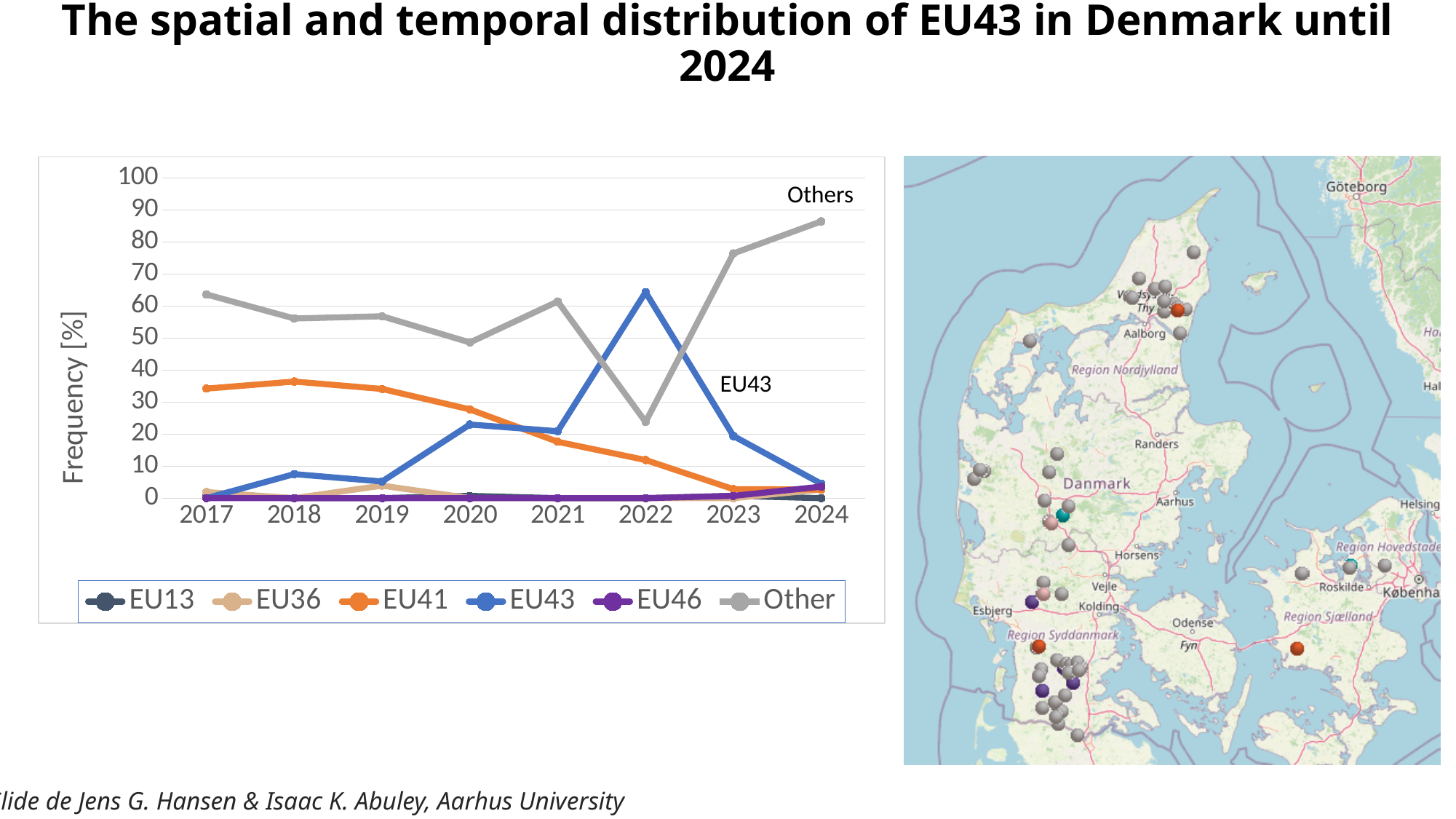
Is the value for EU41 in 2023 greater or less than 10? less In 2022, which series has the larger value, EU43 or Other? EU43 Is the value for EU43 in 2022 greater or less than 60? greater Does the EU41 series rise or fall from 2018 to 2024? fall What kind of chart is shown on the left of the slide? line chart Is the value for EU41 in 2018 greater or less than 30? greater In which year does the Other series reach its lowest value? 2022 What is the label of the y axis of the line chart? Frequency [%] In which year does the EU43 series reach its highest value? 2022 How many series does the legend of the line chart list? 6 How many years are shown along the x axis of the line chart? 8